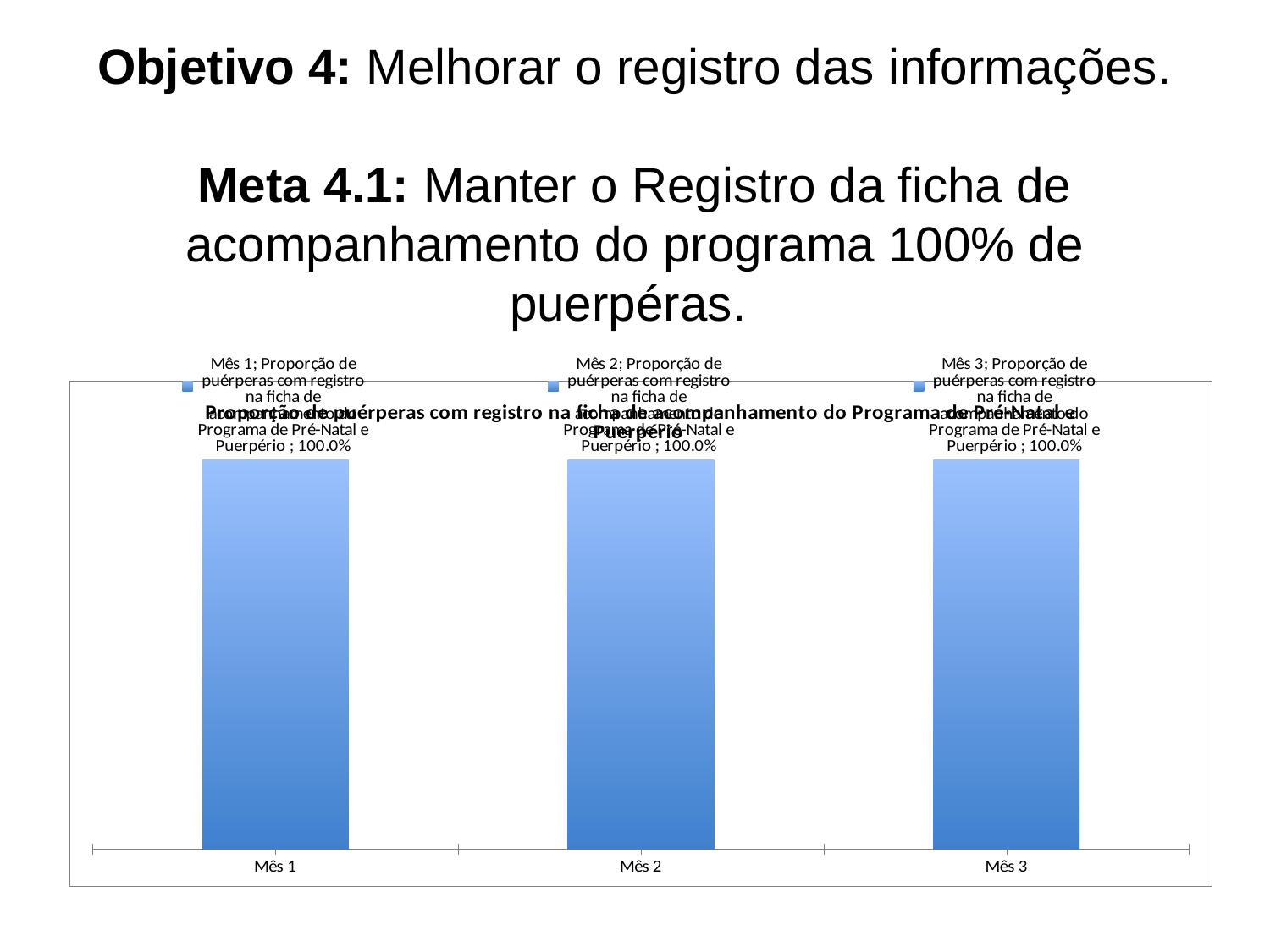
What is the value for Mês 3? 100.0% Do the values rise, fall, or stay the same from Mês 1 to Mês 3? stay the same What are the labels of the categories on the x axis, in order? Mês 1, Mês 2, Mês 3 What is the difference between the values for Mês 1 and Mês 3? 0.0% What colour are the bars in the chart? blue What kind of chart is shown on the slide? bar chart What is the value for Mês 2? 100.0% What is the value for Mês 1? 100.0% How many categories are shown on the x axis of the chart? 3